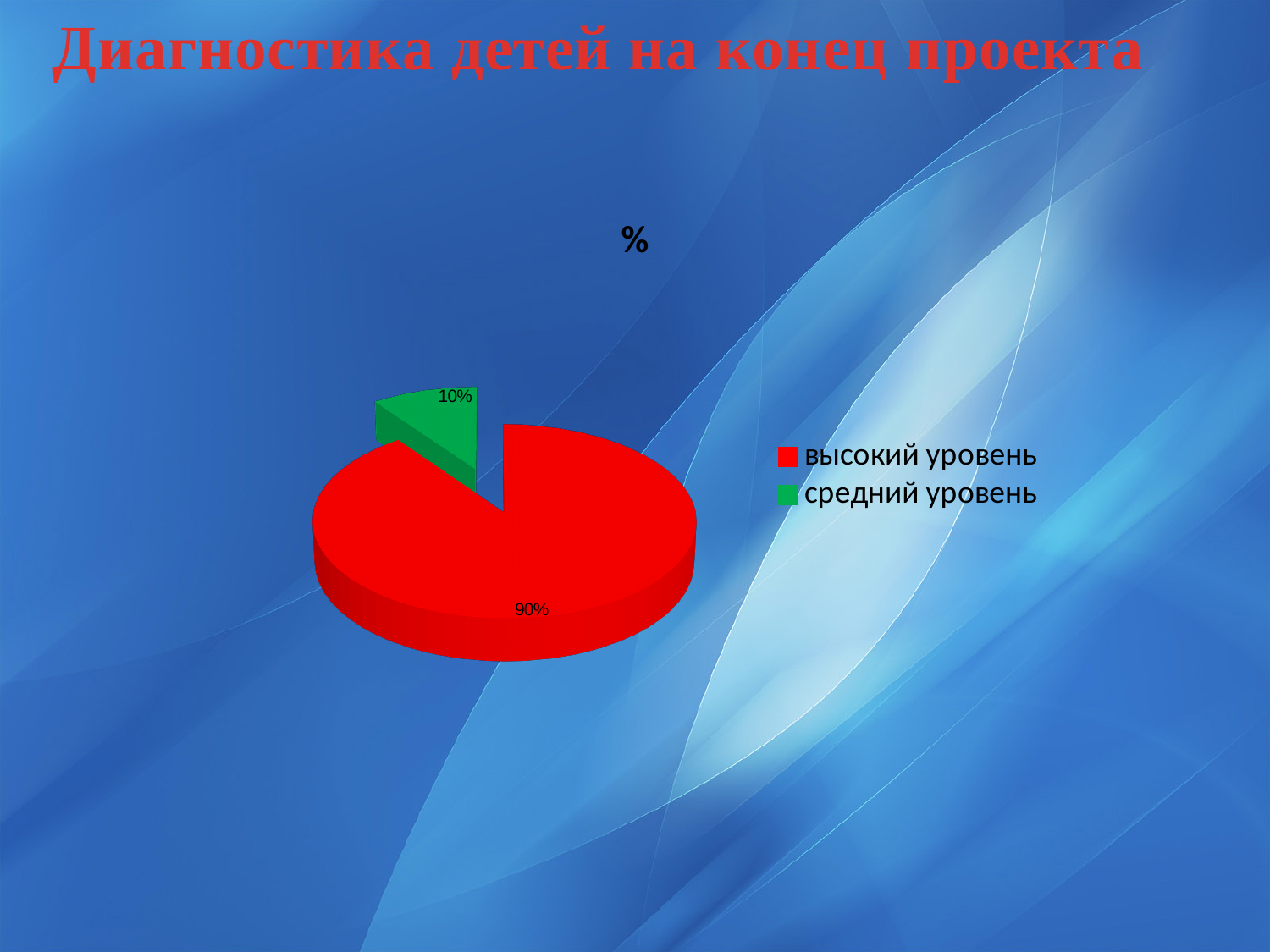
What share of the pie does средний уровень take? 10% What is the value for средний уровень? 10% What kind of chart is shown on the slide? pie chart Which category has the largest slice? высокий уровень How many entries does the legend list? 2 Which category has the smallest slice? средний уровень What colour is the slice for средний уровень? green How many slices does the pie chart have? 2 What is the title of the chart? % Which is larger, the slice for высокий уровень or the slice for средний уровень? высокий уровень What is the value for высокий уровень? 90% What is the difference between the values for высокий уровень and средний уровень? 80%